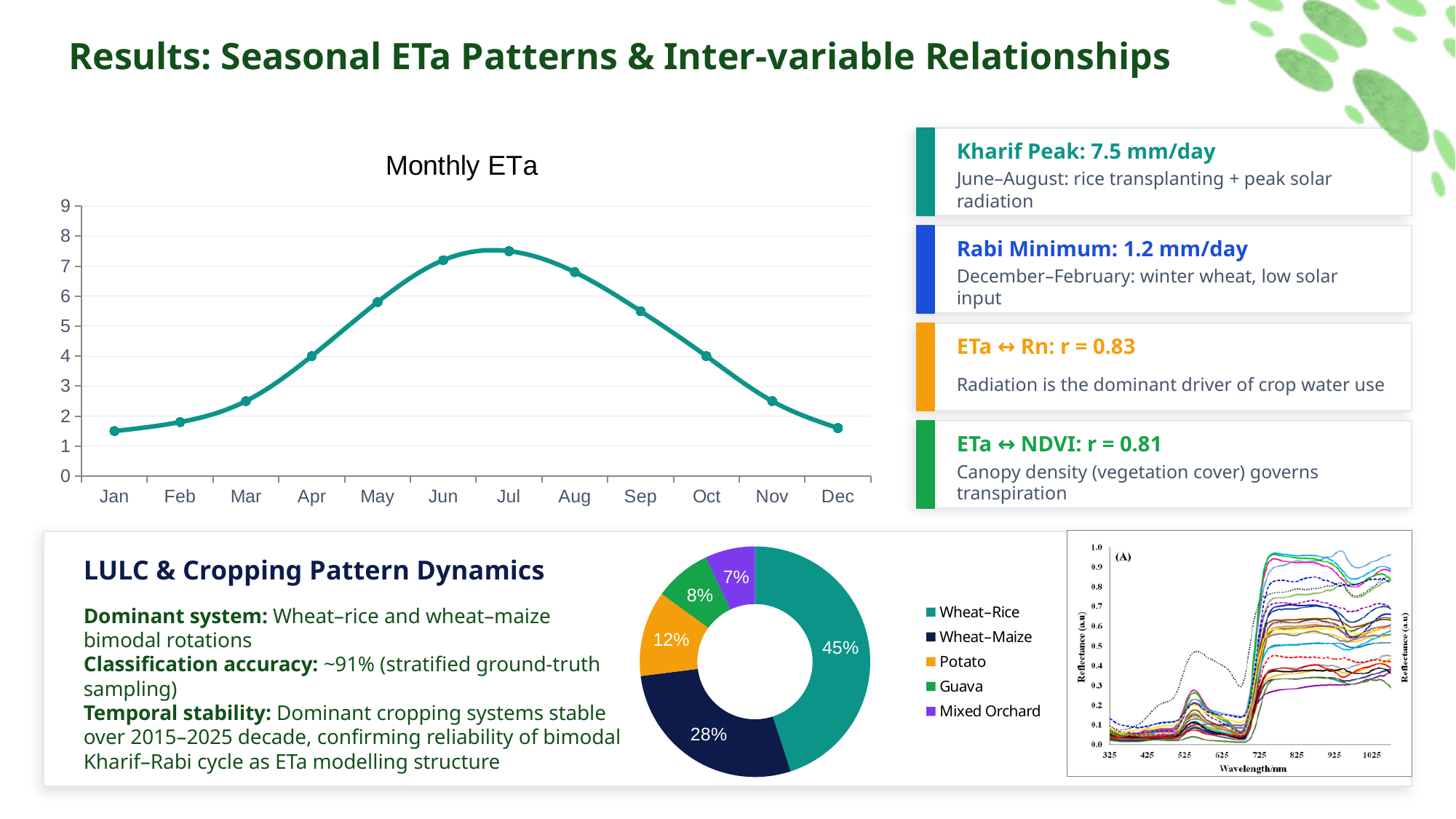
In the donut chart in the LULC & Cropping Pattern Dynamics section, what is the difference between the Wheat–Rice and Wheat–Maize shares? 17% In the Monthly ETa chart, is the value for Jun greater or less than 7? greater In the donut chart in the LULC & Cropping Pattern Dynamics section, what share does Wheat–Rice have? 45% How many categories does the legend of the donut chart in the LULC & Cropping Pattern Dynamics section list? 5 What kind of chart is the Monthly ETa chart? line chart In the Monthly ETa chart, which is larger, the value for May or the value for Nov? May In the donut chart in the LULC & Cropping Pattern Dynamics section, what is the value for Potato? 12% In the Monthly ETa chart, which month has the highest ETa value? Jul In the Monthly ETa chart, do the values rise or fall from Jul to Dec? fall How many months are plotted on the x axis of the Monthly ETa chart? 12 In the Monthly ETa chart, is the value for Mar greater or less than 3? less In the Monthly ETa chart, is the value for Sep greater or less than 5? greater